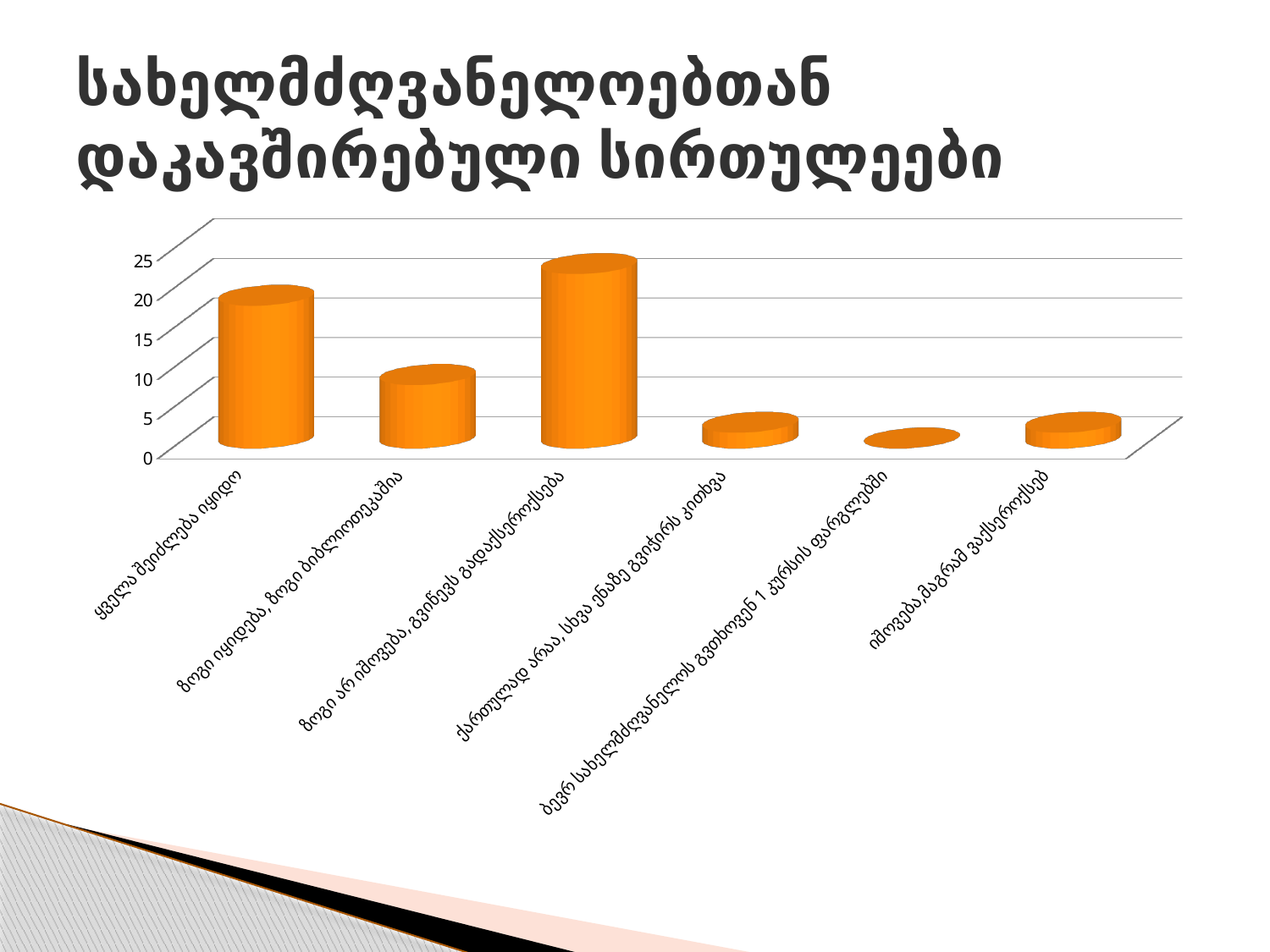
What kind of chart is shown on the slide? bar chart Which is larger: the value for "ზოგი არ იშოვება, გვიწევს გადაქსეროქსება" or the value for "ყველა შეიძლება იყიდო"? ზოგი არ იშოვება, გვიწევს გადაქსეროქსება Is the value for "ყველა შეიძლება იყიდო" greater or less than 15? greater Is the value for "ზოგი იყიდება, ზოგი ბიბლიოთეკაშია" greater or less than 15? less What is the title of the slide containing the chart? სახელმძღვანელოებთან დაკავშირებული სირთულეები Which is larger: the value for "ყველა შეიძლება იყიდო" or the value for "ზოგი იყიდება, ზოგი ბიბლიოთეკაშია"? ყველა შეიძლება იყიდო Is the value for "ქართულად არაა, სხვა ენაზე გვიჭირს კითხვა" greater or less than 10? less How many categories are plotted in the chart? 6 Which category has the highest bar? ზოგი არ იშოვება, გვიწევს გადაქსეროქსება Which category has the lowest bar? ბევრ სახელმძღვანელოს გვთხოვენ 1 კურსის ფარგლებში